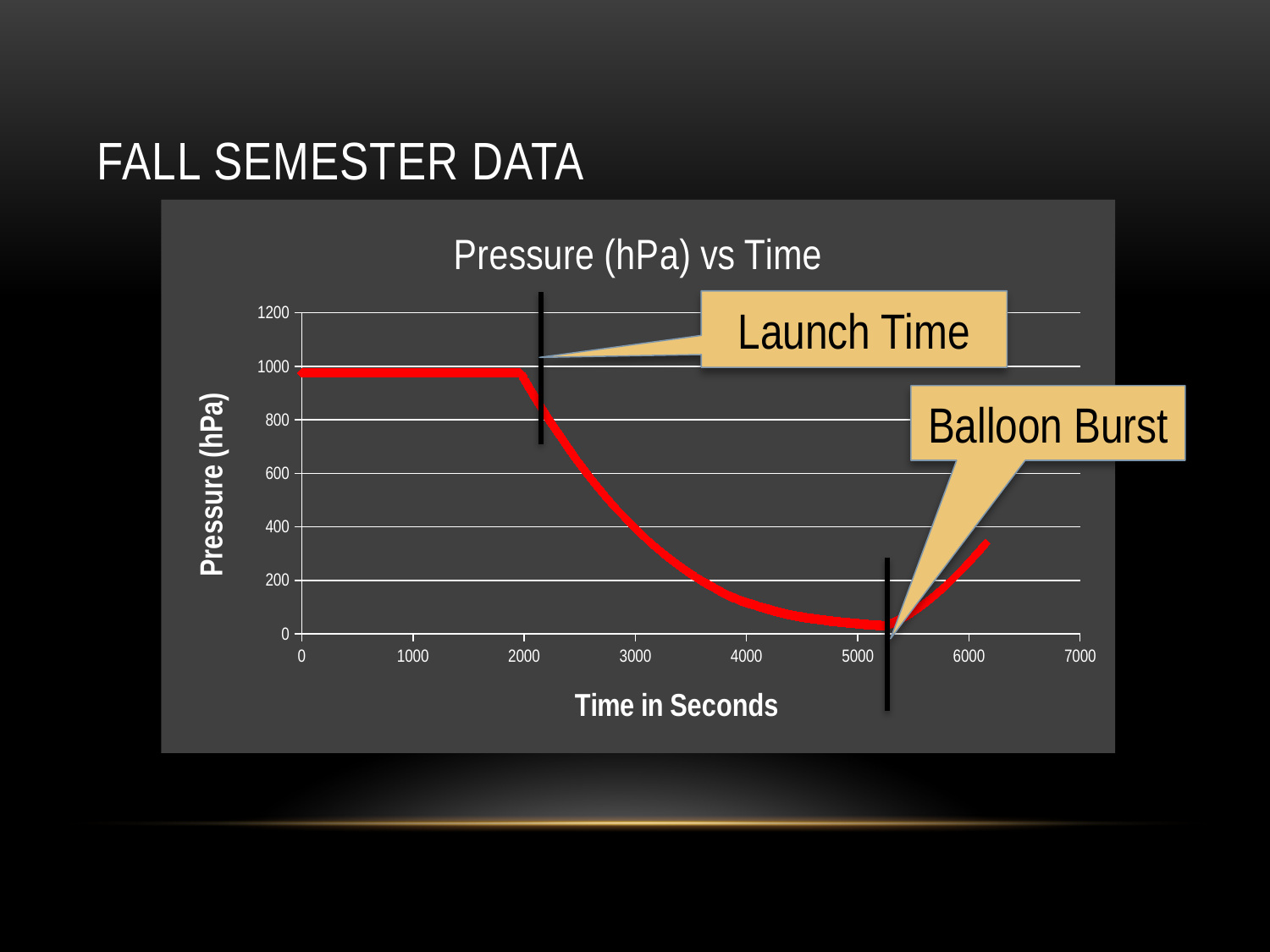
Does the pressure rise or fall between 5500 and 6000 seconds? rise Is the pressure value at 1000 seconds greater or less than 1000? less Is the pressure value at 1000 seconds greater or less than 800? greater Does the pressure rise or fall between 2000 and 5000 seconds? fall Is the pressure value at 3000 seconds greater or less than 600? less What kind of chart is shown on the slide? line chart Which is larger, the pressure at 1000 seconds or the pressure at 4000 seconds? 1000 seconds What is the label on the horizontal axis of the chart? Time in Seconds What is the title of the chart? Pressure (hPa) vs Time